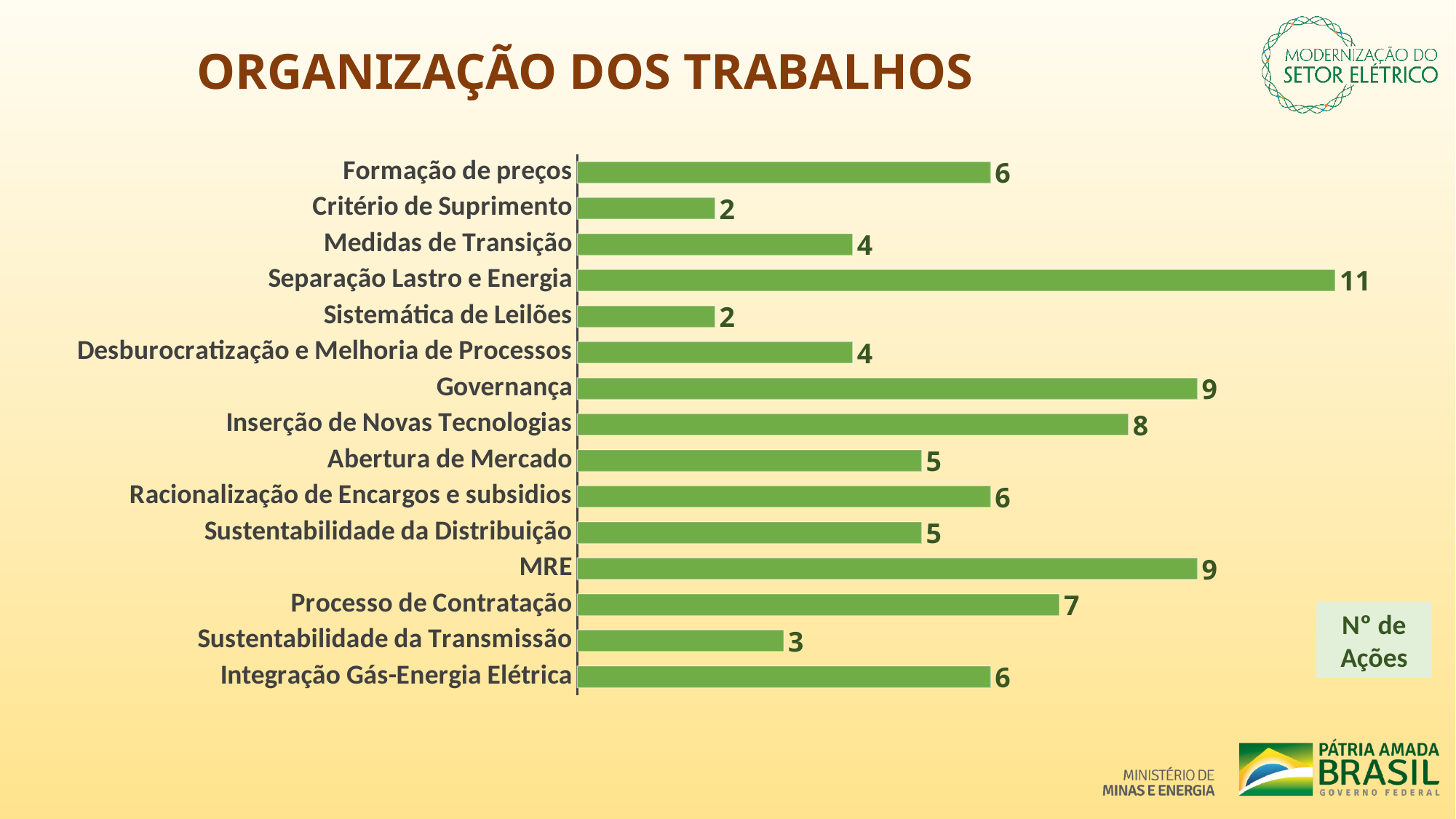
Which is larger, the value for MRE or the value for Abertura de Mercado? MRE What type of chart is shown on the slide? bar chart What is the value for Sustentabilidade da Transmissão? 3 How many categories are plotted in the chart? 15 What is the difference between the values for Separação Lastro e Energia and Processo de Contratação? 4 What is the value for Separação Lastro e Energia? 11 What is the lowest value shown in the chart? 2 What is the title of the slide containing the chart? ORGANIZAÇÃO DOS TRABALHOS Which category has the highest value? Separação Lastro e Energia What is the value for Inserção de Novas Tecnologias? 8 What is the difference between the values for Governança and Critério de Suprimento? 7 What is the value for Governança? 9